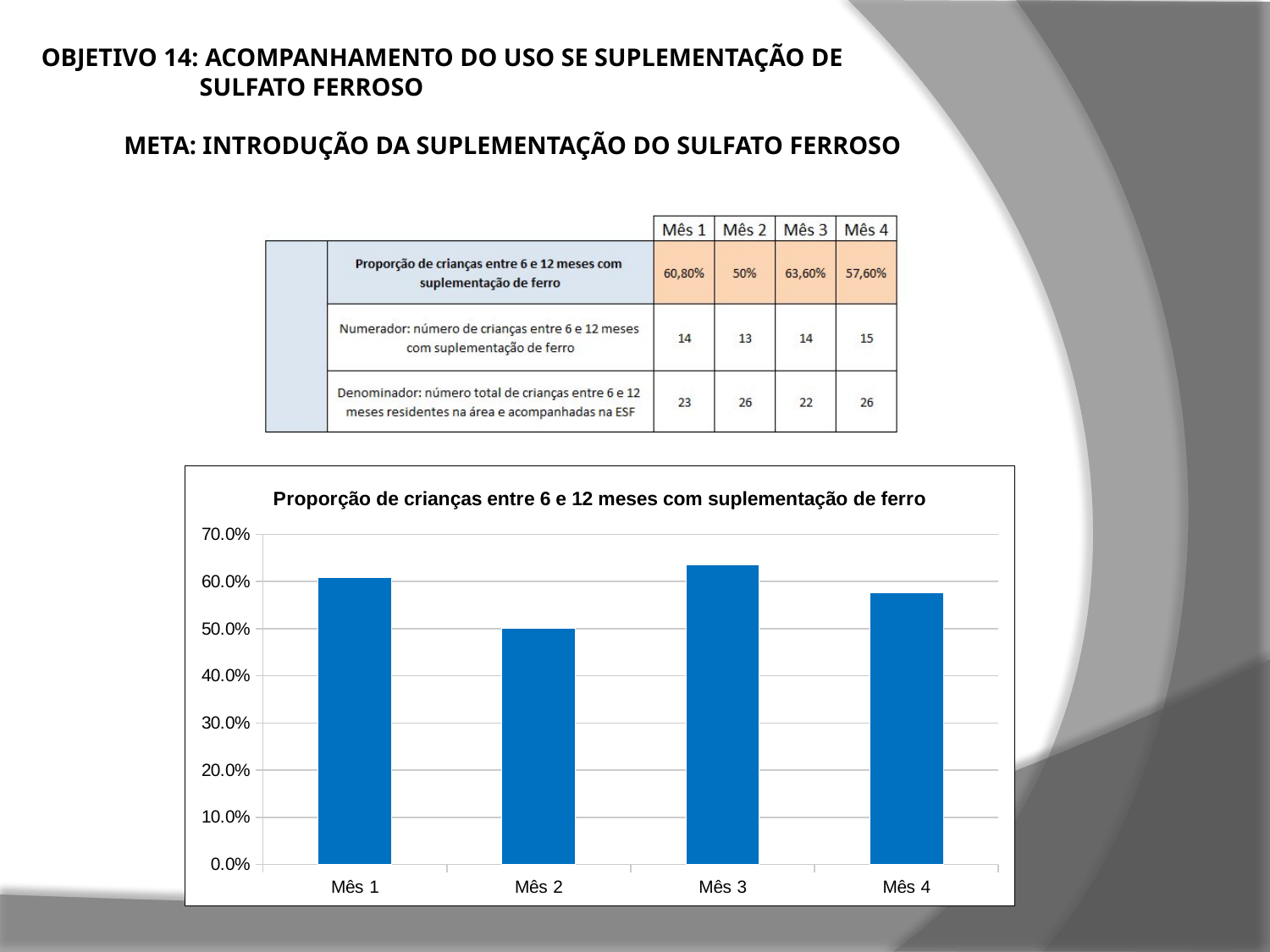
What is the title of the bar chart? Proporção de crianças entre 6 e 12 meses com suplementação de ferro According to the slide, what is the proportion of children aged 6 to 12 months with iron supplementation in Mês 3? 63,60% Which month has the lowest proportion of children with iron supplementation in the bar chart? Mês 2 Is the value for Mês 4 in the bar chart greater or less than 60.0%? less What is the proportion of children with iron supplementation in Mês 2? 50% Which is larger in the bar chart, the value for Mês 1 or the value for Mês 4? Mês 1 According to the slide, what is the proportion of children aged 6 to 12 months with iron supplementation in Mês 4? 57,60% According to the slide, what is the proportion of children aged 6 to 12 months with iron supplementation in Mês 1? 60,80% Which month has the highest proportion of children with iron supplementation in the bar chart? Mês 3 What kind of chart is shown on the slide? bar chart Is the value for Mês 3 in the bar chart greater or less than 60.0%? greater How many months (categories) are plotted in the bar chart? 4